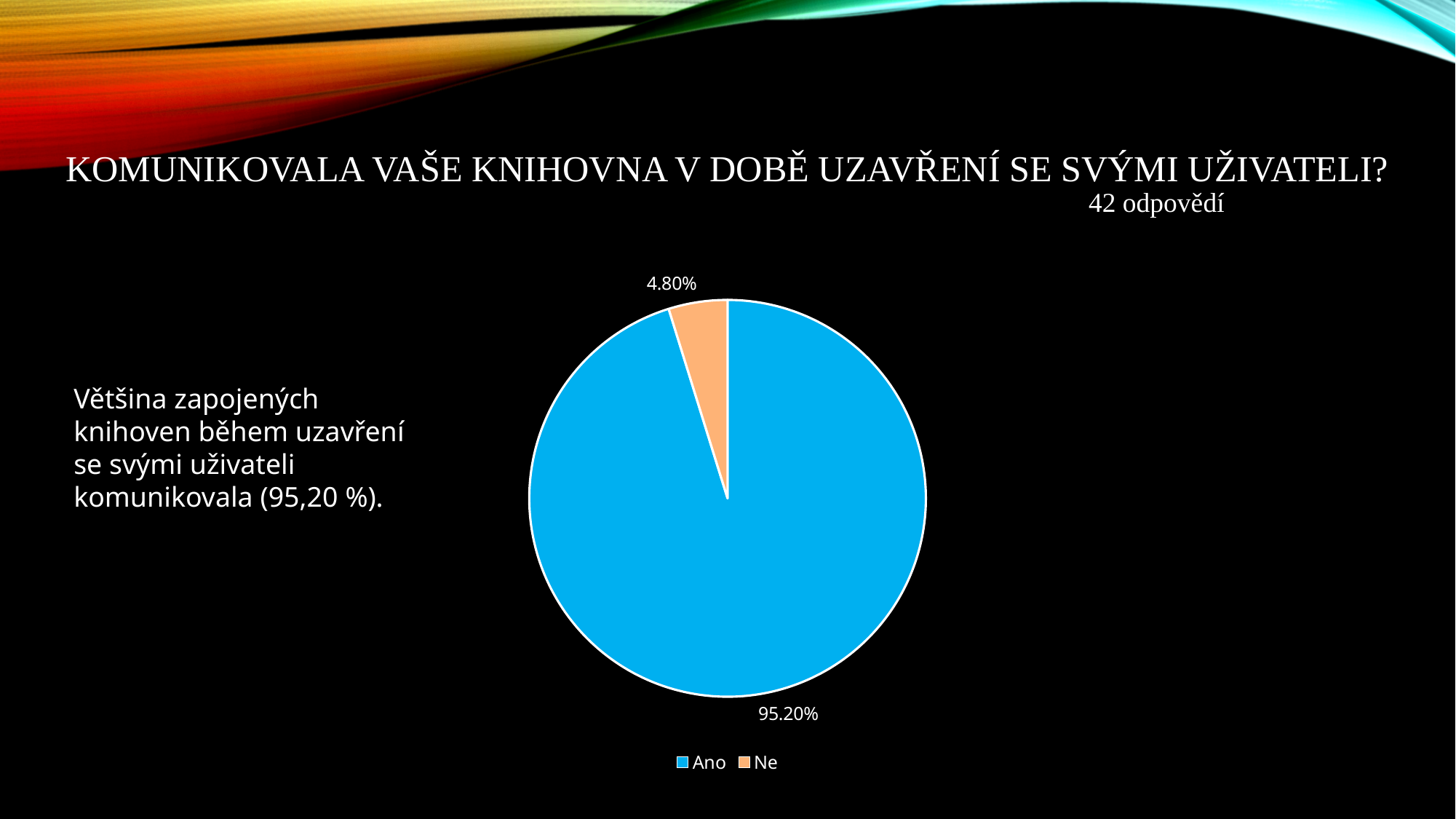
Which slice of the pie is the largest? Ano What is the difference in percentage points between the "Ano" and "Ne" slices? 90.40% What colour is the "Ne" slice in the pie chart? orange Which is larger, the "Ano" slice or the "Ne" slice? Ano What share of the pie does the "Ne" slice represent? 4.80% How many entries does the legend list? 2 What kind of chart is shown on the slide? pie chart What share of the pie does the "Ano" slice represent? 95.20% How many responses does the slide say the chart is based on? 42 How many slices does the pie chart have? 2 Which slice of the pie is the smallest? Ne